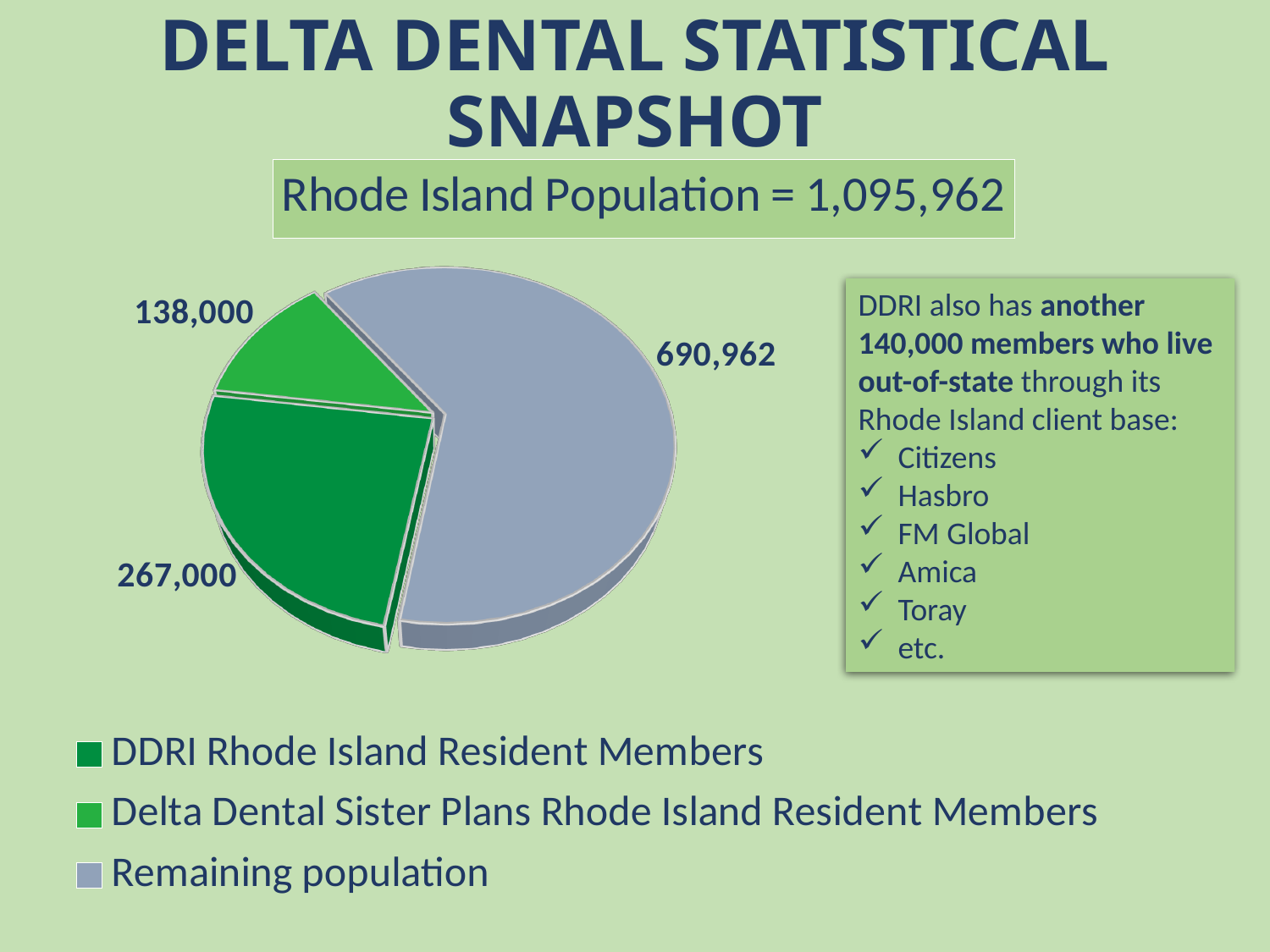
How many slices does the pie chart have? 3 Which colour represents the Remaining population in the pie chart? Gray-blue What value is shown for Delta Dental Sister Plans Rhode Island Resident Members? 138,000 What is the total of all three slices in the pie chart? 1,095,962 What value is shown for DDRI Rhode Island Resident Members in the pie chart? 267,000 Which slice of the pie chart is the largest? Remaining population Which is larger: DDRI Rhode Island Resident Members or Delta Dental Sister Plans Rhode Island Resident Members? DDRI Rhode Island Resident Members What type of chart is shown on the slide? Pie chart What value is shown for the Remaining population slice? 690,962 What is the difference between the Remaining population value and the DDRI Rhode Island Resident Members value? 423,962 How much larger is the DDRI Rhode Island Resident Members value than the Delta Dental Sister Plans Rhode Island Resident Members value? 129,000 Which slice of the pie chart is the smallest? Delta Dental Sister Plans Rhode Island Resident Members